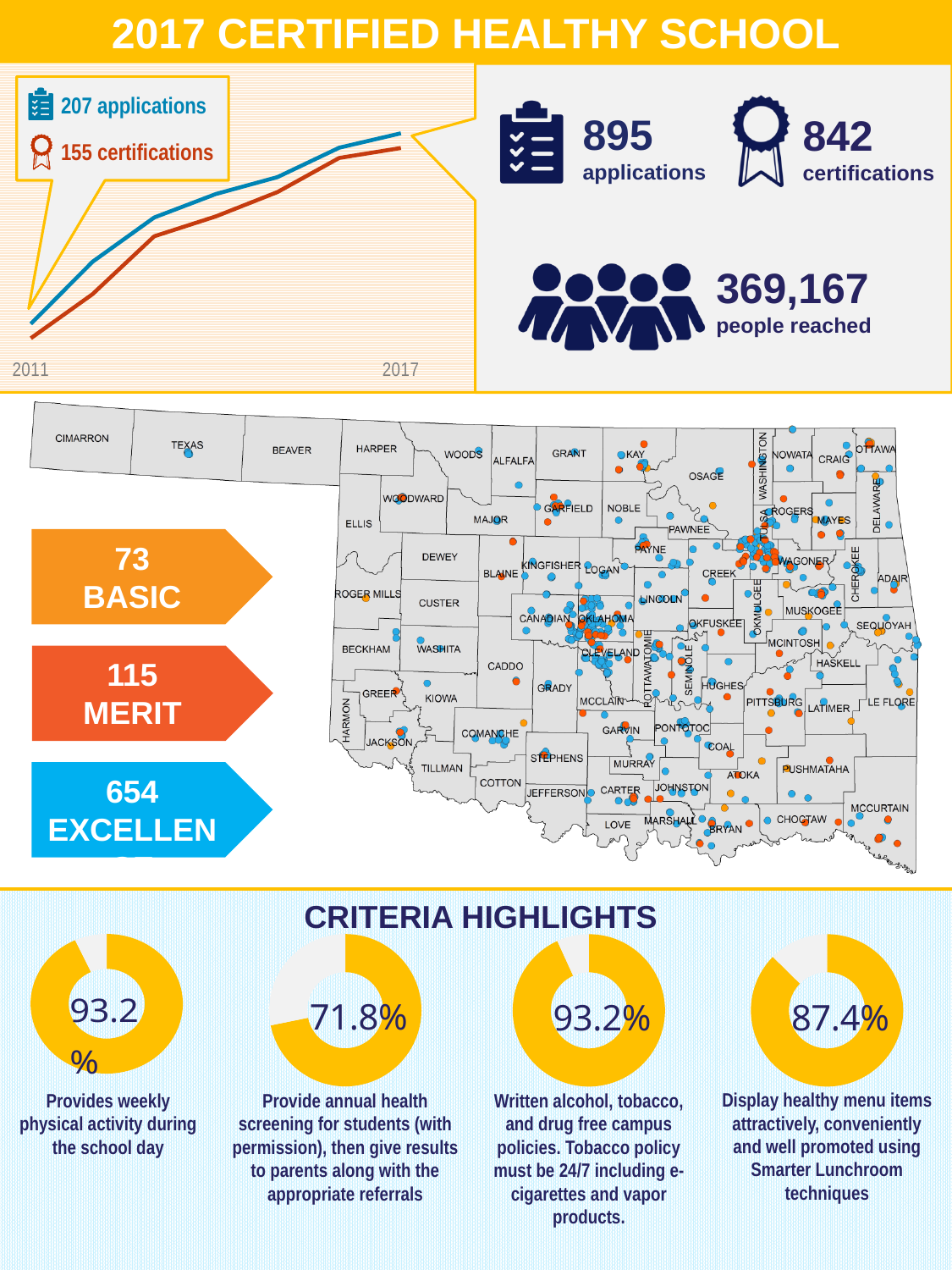
In the Criteria Highlights section, which criterion has the lowest percentage? Provide annual health screening for students In the top-left line chart, how many applications are shown in the callout for 2017? 895 How many donut charts are shown in the Criteria Highlights section? 4 In the Criteria Highlights section, what percentage is shown for 'Provide annual health screening for students'? 71.8% In the top-left line chart, how many certifications are shown in the callout for 2017? 842 In the top-left line chart, do the lines rise or fall from 2011 to 2017? Rise In the Criteria Highlights section, what percentage is shown for 'Provides weekly physical activity during the school day'? 93.2% In the Criteria Highlights section, what percentage is shown for 'Display healthy menu items attractively, conveniently and well promoted using Smarter Lunchroom techniques'? 87.4% In the top-left line chart, what is the first year labelled on the x axis? 2011 In the top-left line chart, which is larger in 2017: applications or certifications? Applications In the top-left line chart, what is the difference between the 2017 applications and certifications shown in the callout? 53 What kind of chart is shown in the top-left panel with the years 2011 and 2017 on the x axis? Line chart